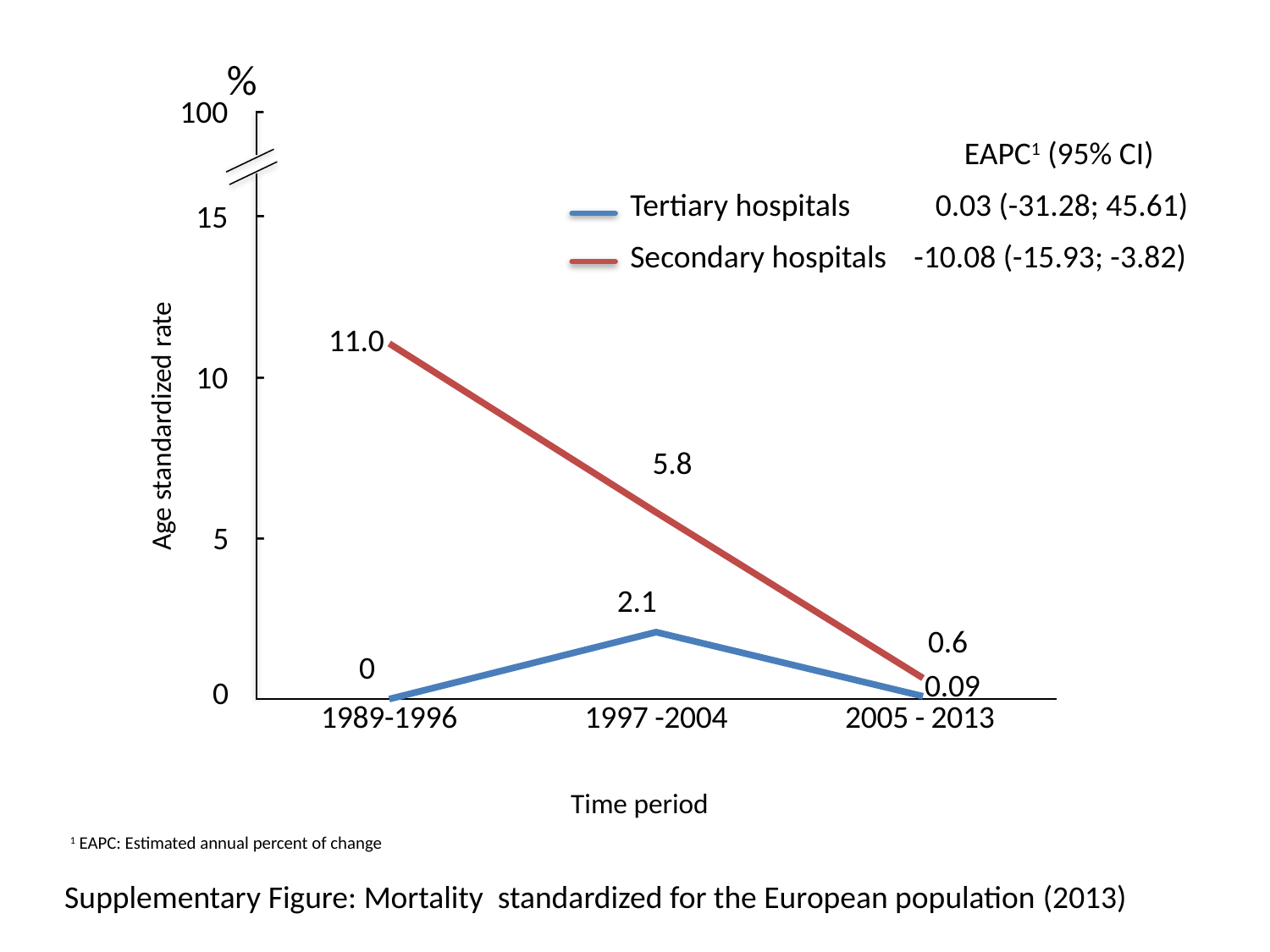
What is the age standardized rate for Tertiary hospitals in 1997 -2004? 2.1 What type of chart is shown on the slide? line chart Does the Secondary hospitals rate rise or fall across the time periods? fall Which series has the higher rate in 1997 -2004, Tertiary hospitals or Secondary hospitals? Secondary hospitals What is the age standardized rate for Tertiary hospitals in 2005 - 2013? 0.09 How many series does the legend list? 2 What is the age standardized rate for Secondary hospitals in 2005 - 2013? 0.6 What is the difference between the Secondary hospitals rate in 1989-1996 and in 1997 -2004? 5.2 In which time period is the Tertiary hospitals rate lowest? 1989-1996 In which time period is the Secondary hospitals rate highest? 1989-1996 What is the age standardized rate for Secondary hospitals in 1989-1996? 11.0 How many time periods are shown on the x axis? 3